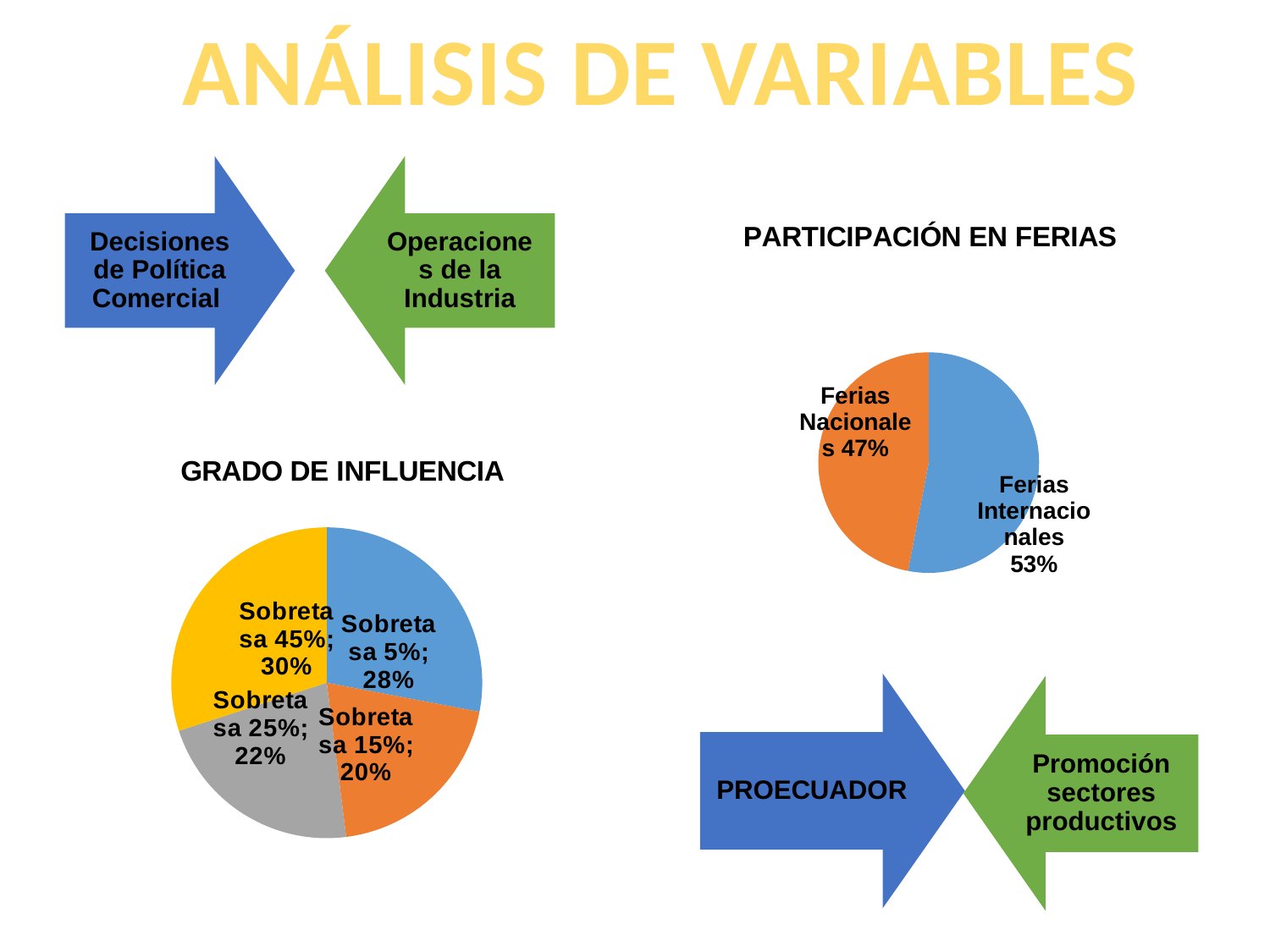
In the GRADO DE INFLUENCIA chart, which slice is the largest? Sobretasa 45% What kind of chart is the GRADO DE INFLUENCIA chart? Pie chart In the PARTICIPACIÓN EN FERIAS chart, what share do Ferias Nacionales have? 47% In the PARTICIPACIÓN EN FERIAS chart, what colour is the Ferias Nacionales slice? Orange In the PARTICIPACIÓN EN FERIAS chart, which is larger, Ferias Nacionales or Ferias Internacionales? Ferias Internacionales In the GRADO DE INFLUENCIA chart, which slice is the smallest? Sobretasa 15% In the GRADO DE INFLUENCIA chart, what share does the Sobretasa 45% slice have? 30% In the GRADO DE INFLUENCIA chart, what share does the Sobretasa 25% slice have? 22% In the PARTICIPACIÓN EN FERIAS chart, what share do Ferias Internacionales have? 53% In the GRADO DE INFLUENCIA chart, how many slices are there? 4 In the GRADO DE INFLUENCIA chart, what is the difference between the Sobretasa 45% share and the Sobretasa 15% share? 10% In the GRADO DE INFLUENCIA chart, what share does the Sobretasa 5% slice have? 28%